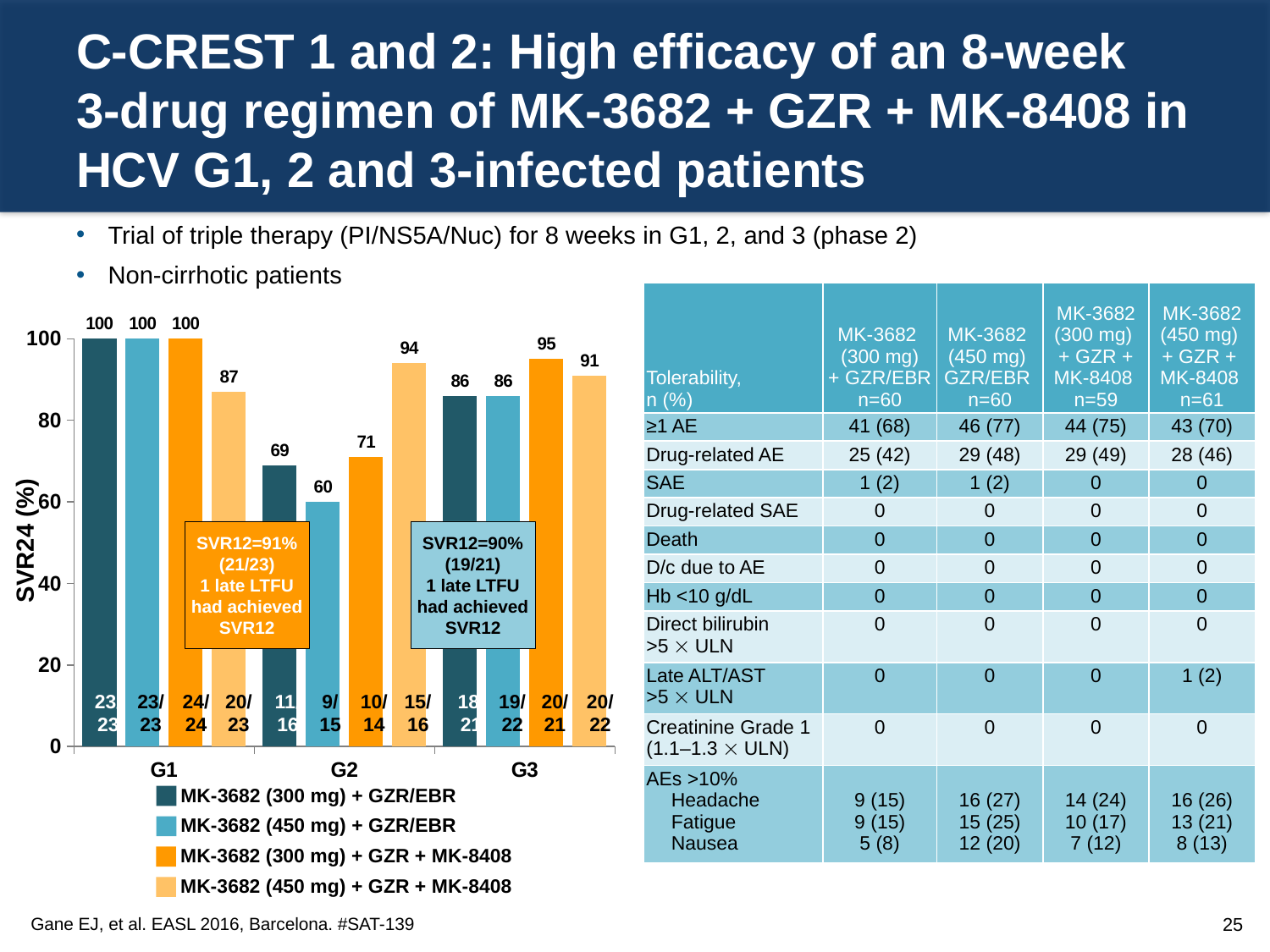
Which regimen has the highest SVR24 (%) in G3? MK-3682 (300 mg) + GZR + MK-8408 What is the label of the y axis of the chart? SVR24 (%) In G3, which is larger: the SVR24 (%) for MK-3682 (300 mg) + GZR + MK-8408 or for MK-3682 (450 mg) + GZR + MK-8408? MK-3682 (300 mg) + GZR + MK-8408 What kind of chart is used to show SVR24 (%)? Bar chart What is the SVR24 (%) for MK-3682 (450 mg) + GZR + MK-8408 in G2? 94 What is the difference in SVR24 (%) between MK-3682 (450 mg) + GZR + MK-8408 and MK-3682 (300 mg) + GZR/EBR in G2? 25 Which regimen has the lowest SVR24 (%) in G2? MK-3682 (450 mg) + GZR/EBR How many genotype groups are shown on the x axis of the chart? 3 What is the SVR24 (%) for MK-3682 (450 mg) + GZR + MK-8408 in G1? 87 What is the SVR24 (%) for MK-3682 (300 mg) + GZR + MK-8408 in G3? 95 How many series does the chart legend list? 4 What is the SVR24 (%) for MK-3682 (450 mg) + GZR/EBR in G2? 60